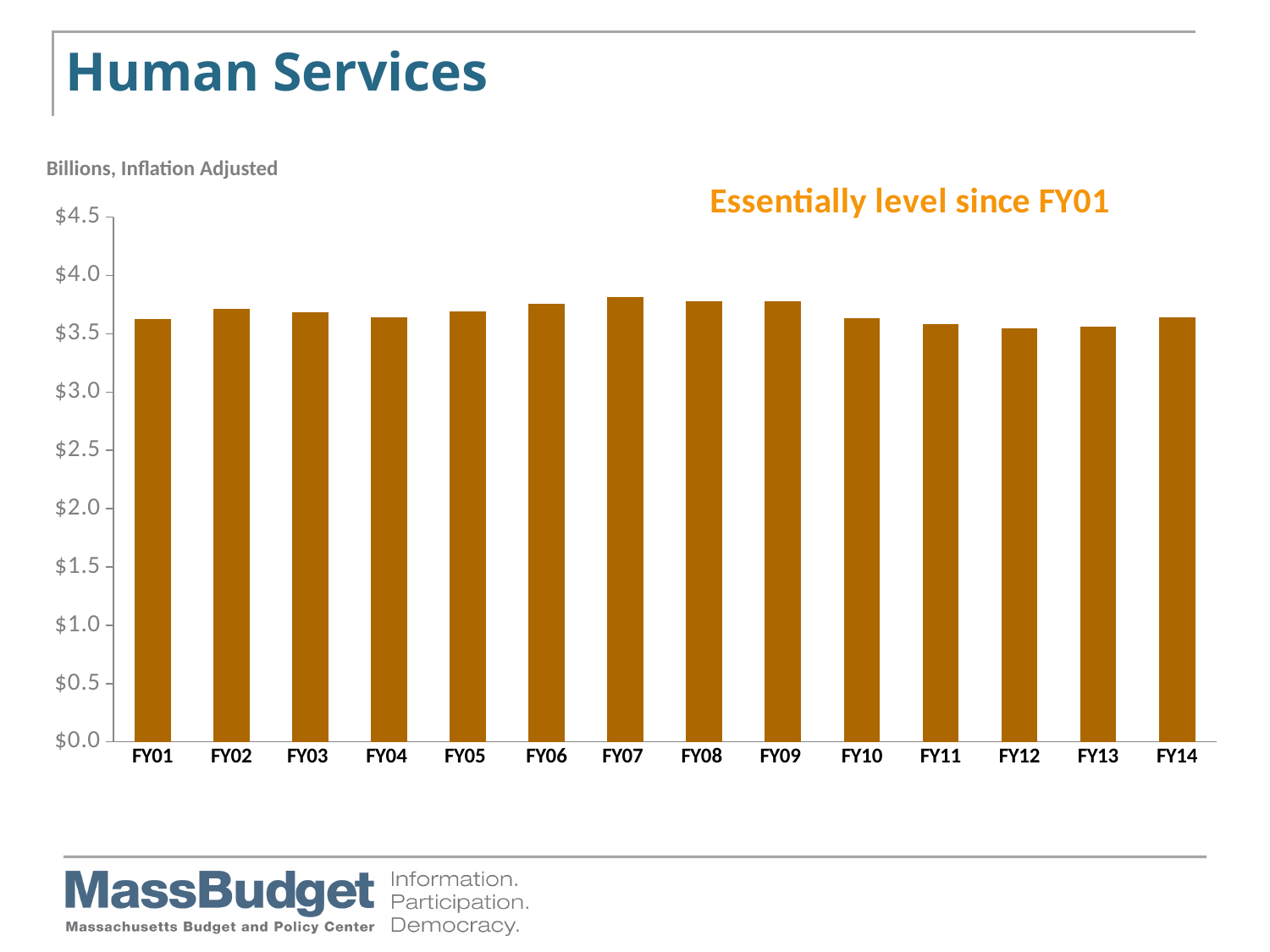
Is the value for FY09 greater or less than $4.0? less Which is larger, the value for FY09 or the value for FY11? FY09 What is the orange annotation text on the chart? Essentially level since FY01 Which is larger, the value for FY07 or the value for FY12? FY07 Is the value for FY01 greater or less than $3.0? greater Is the value for FY07 greater or less than $3.5? greater How many fiscal years are shown on the x axis of the chart? 14 Which is larger, the value for FY06 or the value for FY13? FY06 What unit does the chart say the values are in? Billions, Inflation Adjusted What kind of chart is shown on the slide? bar chart Overall, do the values rise sharply, fall sharply, or stay roughly level from FY01 to FY14? stay roughly level